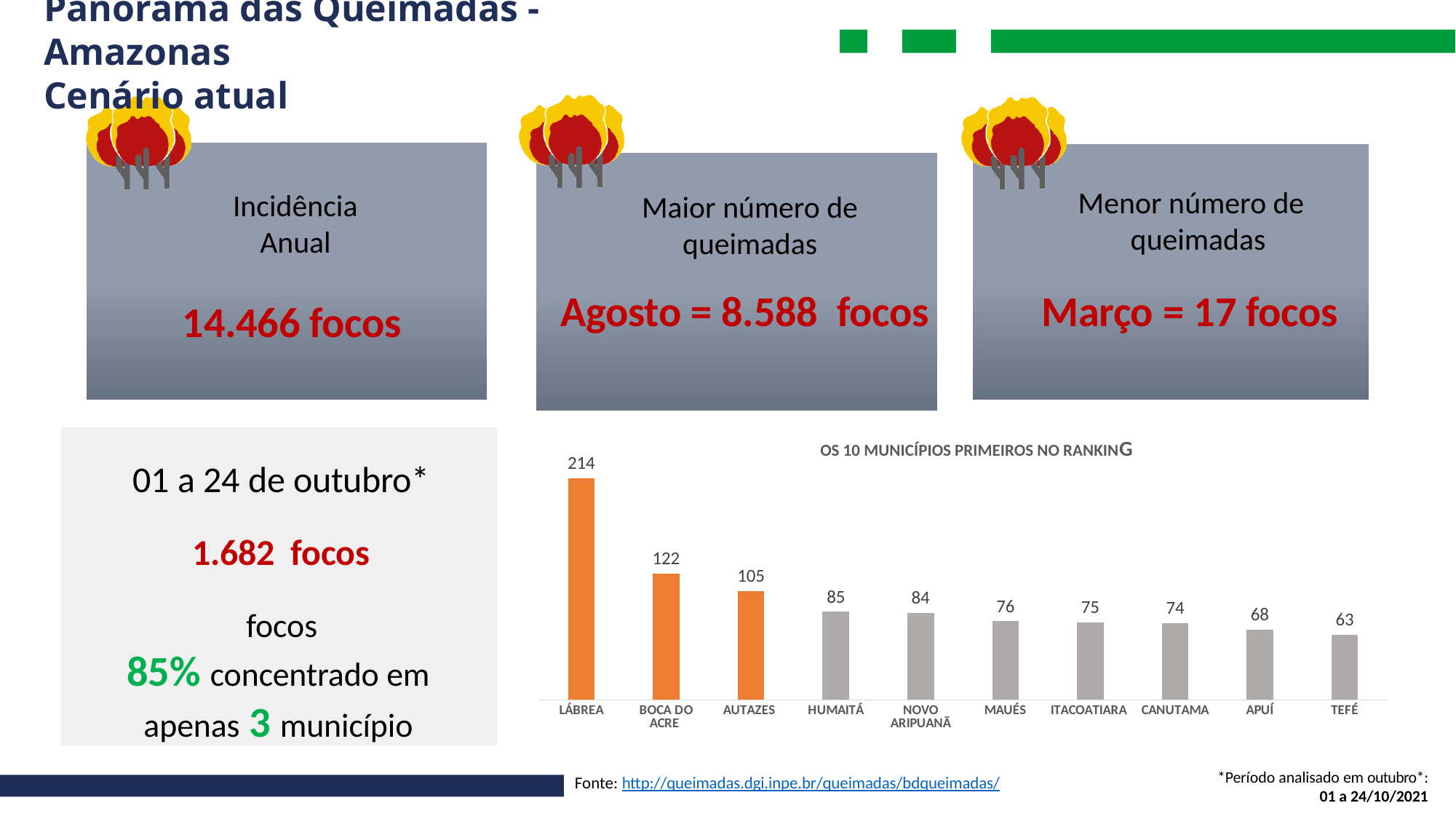
What is the value for LÁBREA in the chart 'OS 10 MUNICÍPIOS PRIMEIROS NO RANKING'? 214 How many bars in the chart are coloured orange? 3 Which is larger, the value for MAUÉS or the value for CANUTAMA? MAUÉS What is the value for HUMAITÁ in the chart? 85 What kind of chart is 'OS 10 MUNICÍPIOS PRIMEIROS NO RANKING'? bar chart What is the difference between the values for LÁBREA and BOCA DO ACRE? 92 What is the difference between the values for AUTAZES and APUÍ? 37 How many municipalities are shown in the chart? 10 Which municipality has the lowest value in the chart? TEFÉ What is the value for TEFÉ in the chart? 63 Which municipality has the highest value in the chart? LÁBREA Do the values rise or fall from left to right across the chart? fall